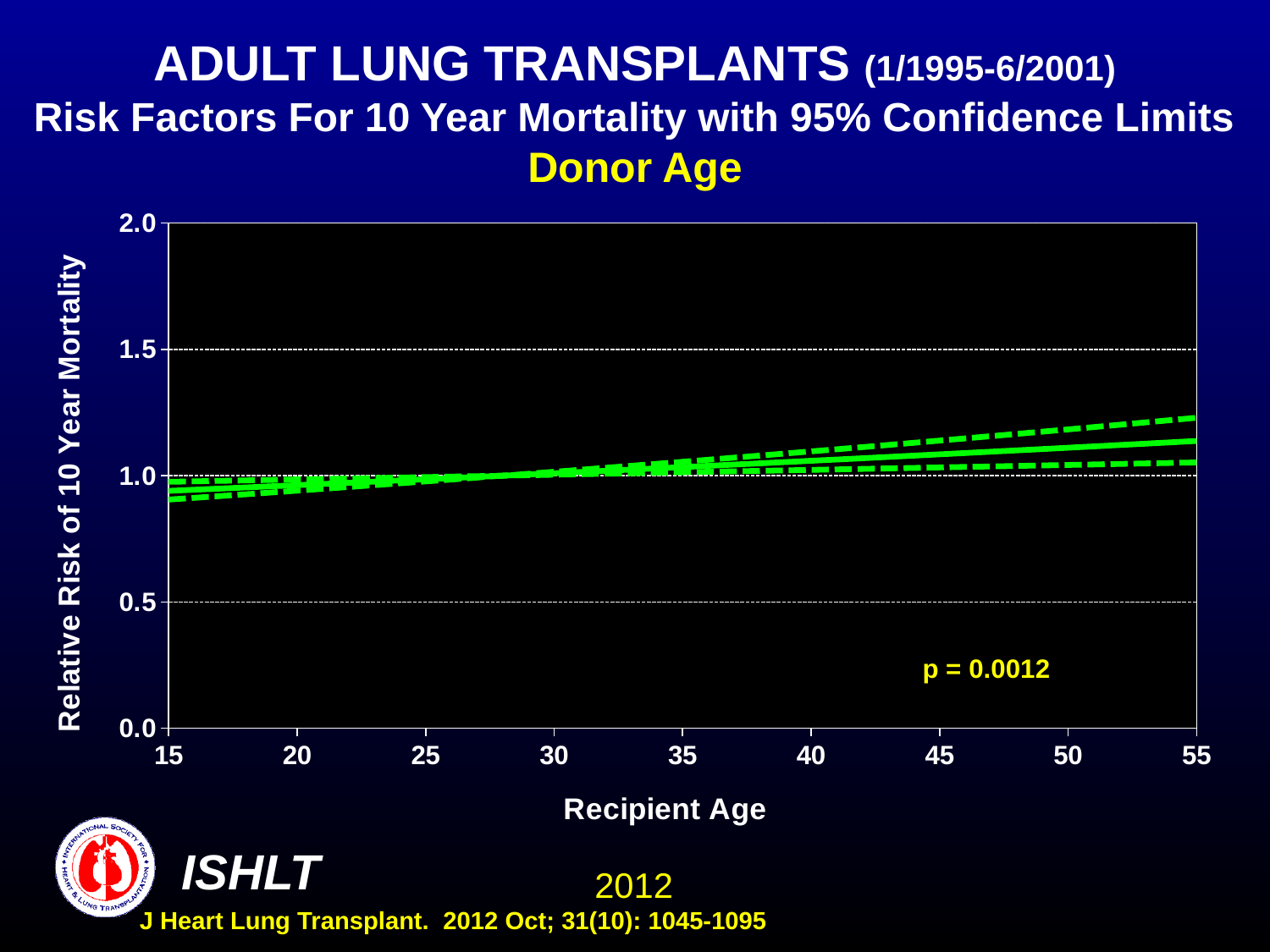
Is the relative risk on the solid line at recipient age 15 greater or less than 1.0? less What is the highest recipient age shown on the x axis? 55 Is the lower dashed confidence limit at recipient age 55 greater or less than 1.0? greater What is the lowest recipient age shown on the x axis? 15 What is the highest value shown on the y axis? 2.0 What p-value is printed on the chart? p = 0.0012 Is the relative risk on the solid line at recipient age 55 greater or less than 1.0? greater What is the label of the y axis? Relative Risk of 10 Year Mortality Does the solid relative risk line rise or fall as recipient age increases from 15 to 55? rise What kind of chart is shown on the slide? line chart How many lines are plotted on the chart? 3